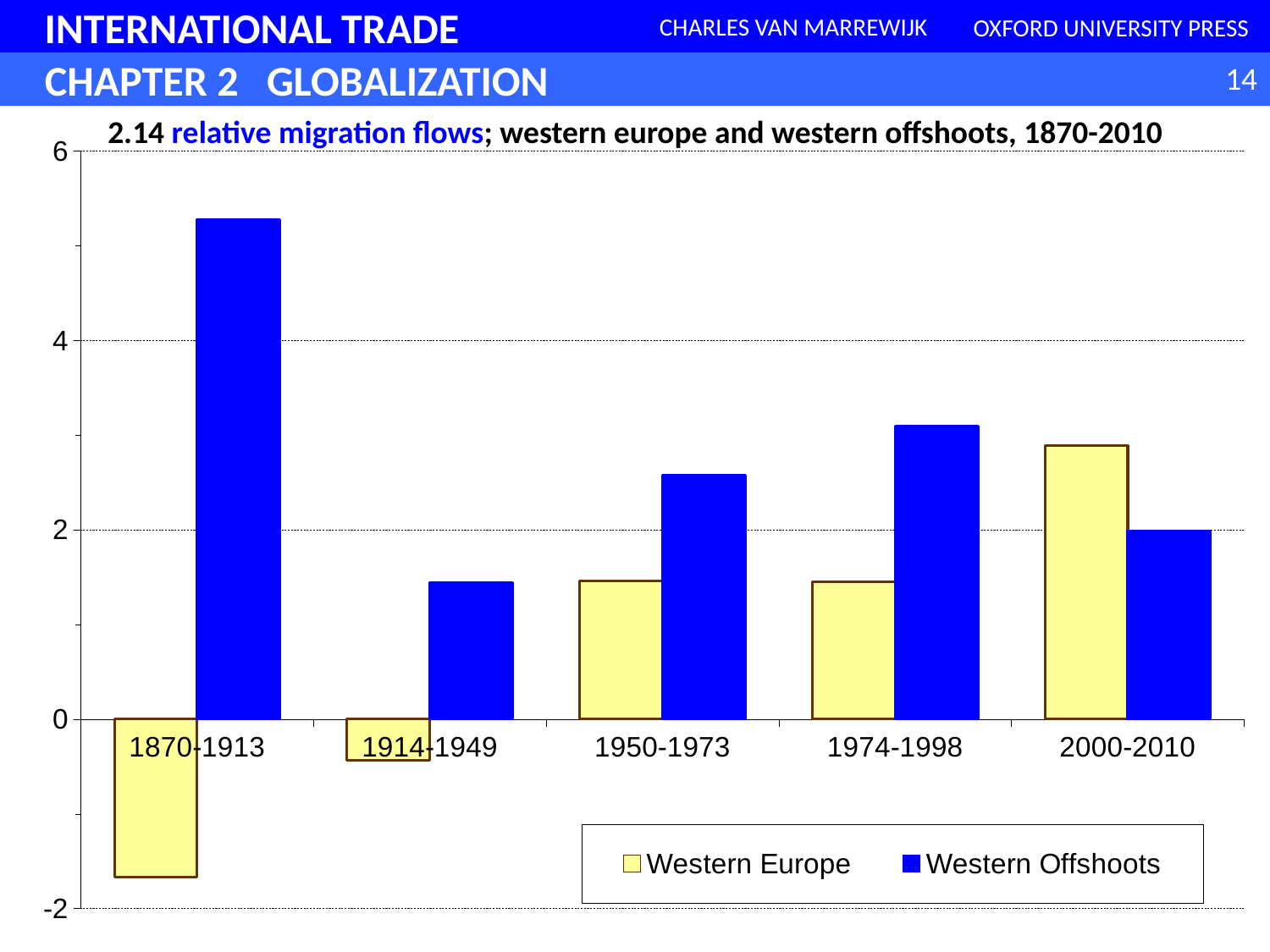
How many time periods are shown on the x axis? 5 Which period has the highest value for Western Offshoots? 1870-1913 What kind of chart is shown on the slide? bar chart Is the value for Western Europe in 1870-1913 greater or less than 0? less Is the value for Western Offshoots in 1870-1913 greater or less than 4? greater How many series does the legend list? 2 Which period has the lowest value for Western Europe? 1870-1913 Which colour represents Western Offshoots in the chart? blue Do the values for Western Europe generally rise or fall from 1870-1913 to 2000-2010? rise In 2000-2010, which series has the larger value, Western Europe or Western Offshoots? Western Europe Is the value for Western Offshoots in 1974-1998 greater or less than 2? greater Which period has the highest value for Western Europe? 2000-2010